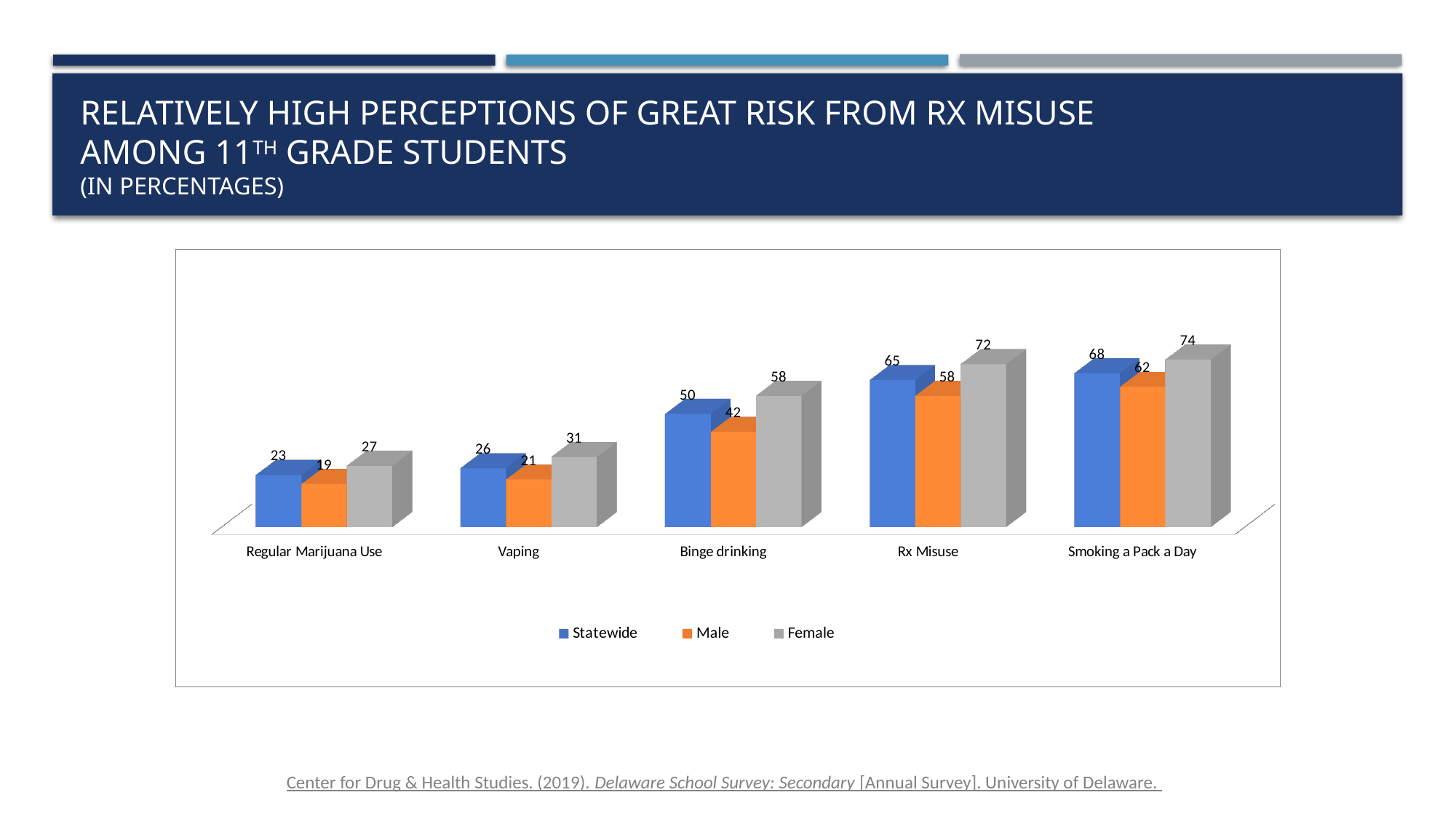
Which colour represents the Male series in the legend? Orange What is the Female value for Binge drinking? 58 What is the difference between the Female and Male values for Rx Misuse? 14 How many categories are shown on the x axis? 5 Do the Statewide values rise or fall from Regular Marijuana Use to Smoking a Pack a Day? Rise How many series does the legend list? 3 Which is larger for Binge drinking, the Statewide value or the Male value? Statewide Which category has the lowest Male value? Regular Marijuana Use What is the Statewide value for Rx Misuse? 65 What is the Male value for Vaping? 21 Which category has the highest Female value? Smoking a Pack a Day What kind of chart is shown on the slide? Bar chart